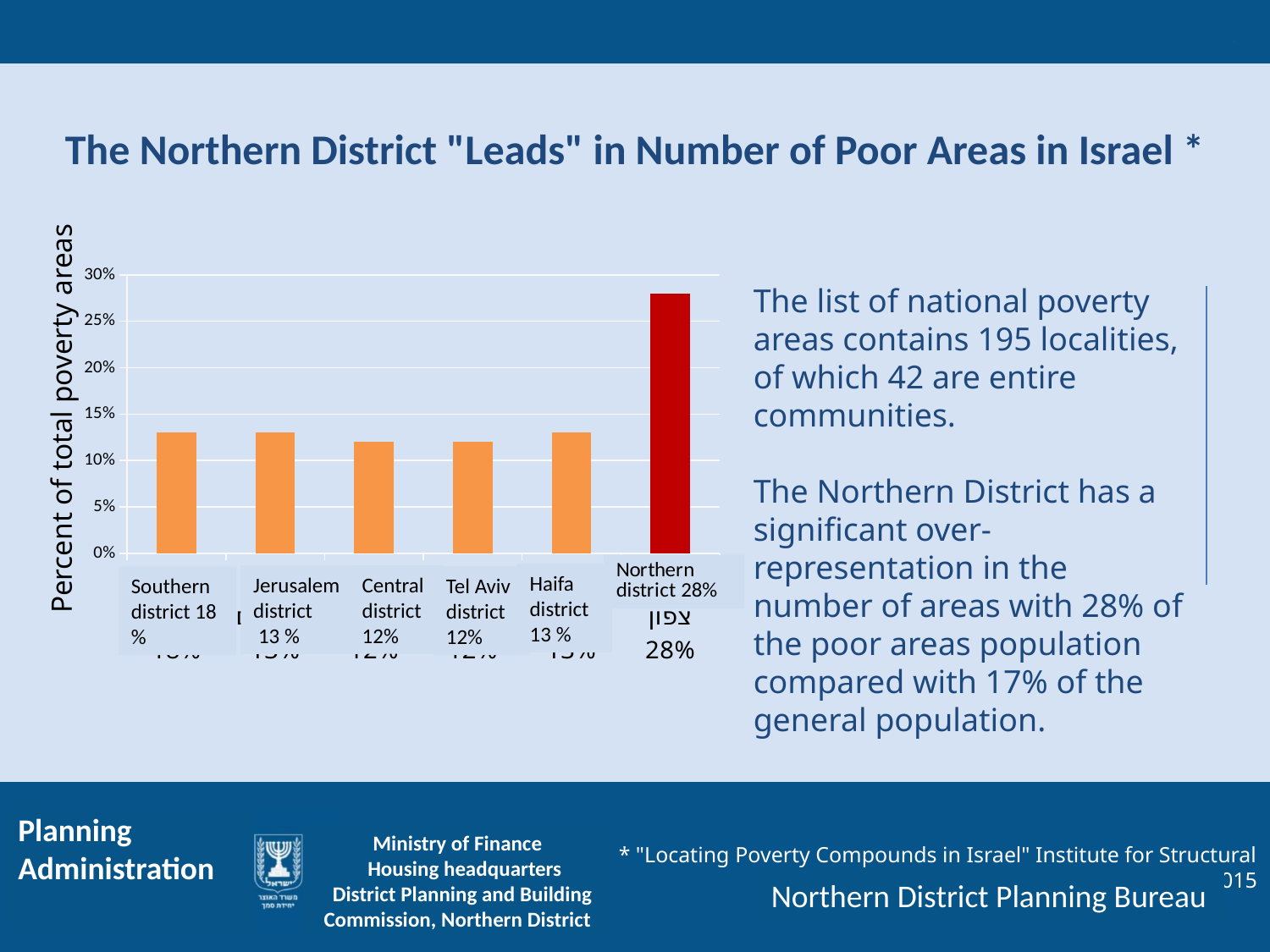
What is the value shown for the Haifa district? 13 % How many districts are plotted in the chart? 6 Which has a larger value, the Northern district or the Haifa district? Northern district What is the value shown for the Central district? 12% What kind of chart is shown on the slide? Bar chart Which district has the highest percent of total poverty areas? Northern district What is the value shown for the Tel Aviv district? 12% What is the value shown for the Jerusalem district? 13 % What is the title of the vertical axis of the chart? Percent of total poverty areas What is the difference between the Northern district's value and the Central district's value? 16 percentage points What is the value shown for the Northern district? 28% Is the value for the Northern district greater or less than 25%? greater